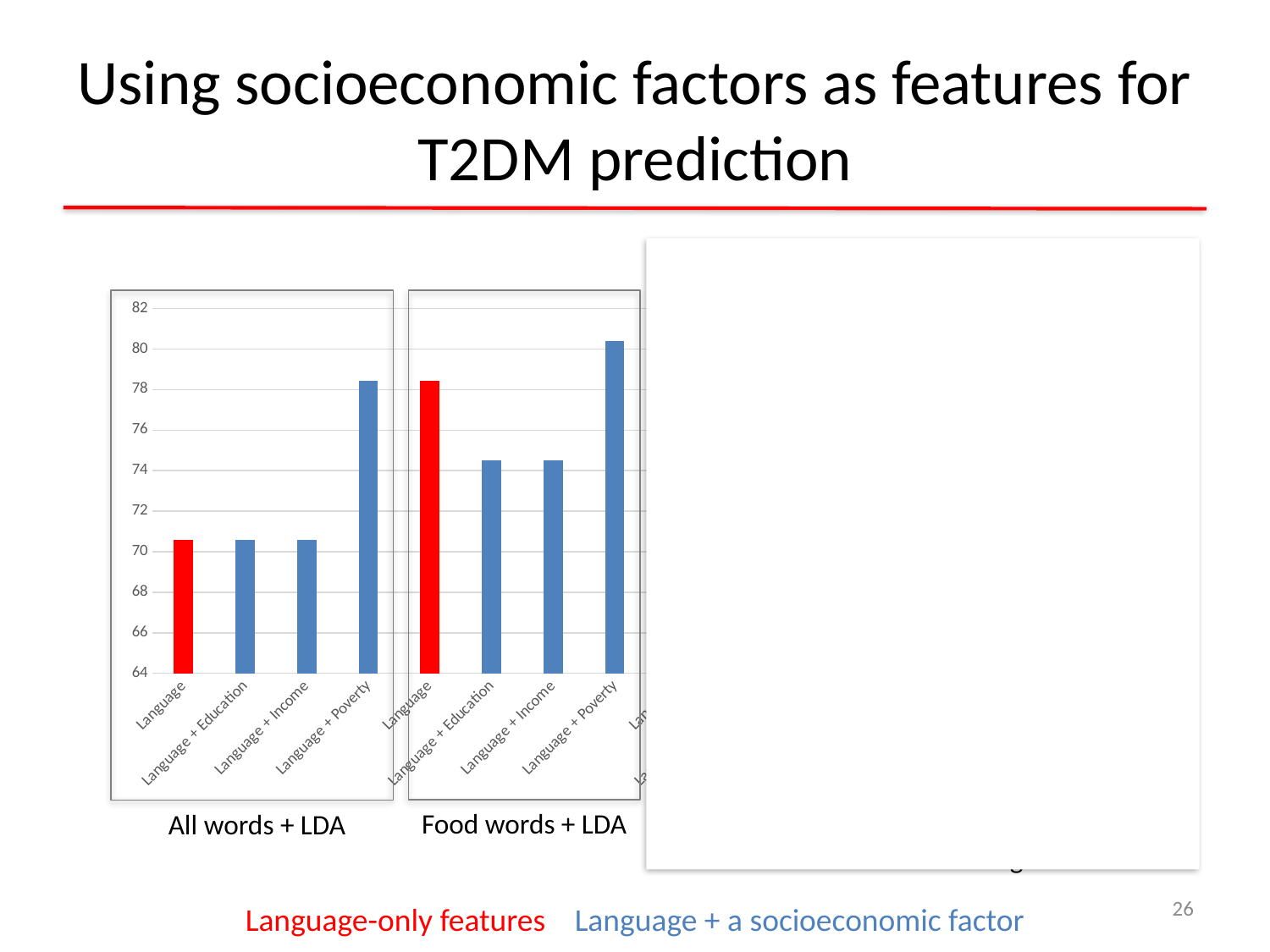
In the 'All words + LDA' chart, is the value for Language greater or less than 72? less In the 'All words + LDA' chart, is the value for Language + Poverty greater or less than 76? greater In the 'Food words + LDA' chart, is the value for Language greater or less than 76? greater What colour is the bar for Language-only features in the charts? red In the 'Food words + LDA' chart, which is larger: the value for Language or the value for Language + Income? Language What kind of chart is the 'All words + LDA' chart? bar chart In the 'Food words + LDA' chart, which category has the highest value? Language + Poverty In the 'All words + LDA' chart, which category has the highest value? Language + Poverty In the 'All words + LDA' chart, which is larger: the value for Language + Poverty or the value for Language + Education? Language + Poverty How many categories are shown in the 'Food words + LDA' chart? 4